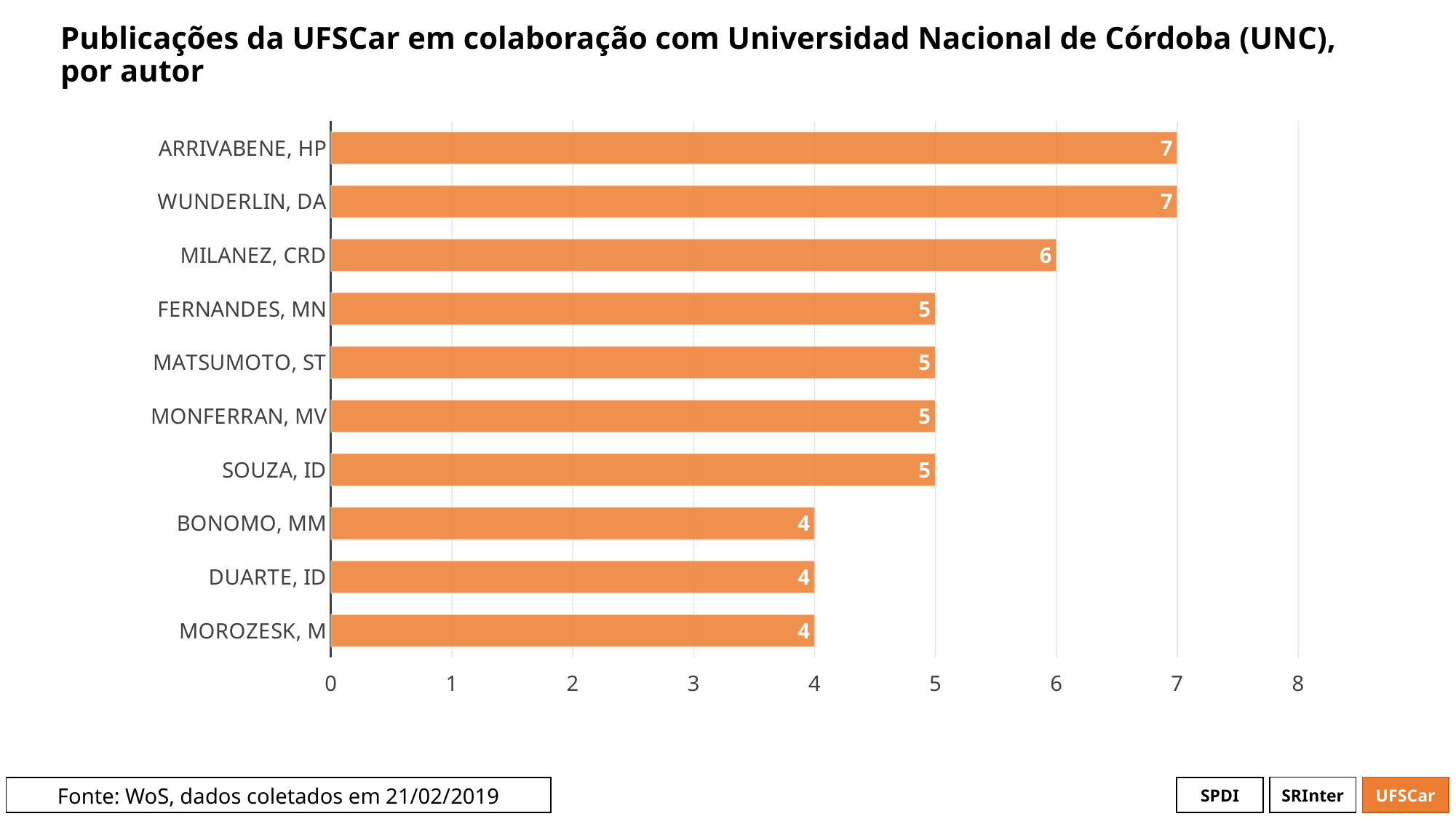
What is the difference between the values for MILANEZ, CRD and FERNANDES, MN? 1 What is the source of the data cited on the slide? WoS, dados coletados em 21/02/2019 What is the difference between the values for ARRIVABENE, HP and BONOMO, MM? 3 What kind of chart is shown on the slide? bar chart What is the value for MOROZESK, M? 4 What is the value for SOUZA, ID? 5 Is the value for MILANEZ, CRD greater or less than 5? greater Which authors have the highest number of publications? ARRIVABENE, HP and WUNDERLIN, DA What is the lowest value shown on the chart? 4 How many publications does MILANEZ, CRD have? 6 How many authors are shown on the chart? 10 Which is larger, the value for WUNDERLIN, DA or the value for MATSUMOTO, ST? WUNDERLIN, DA